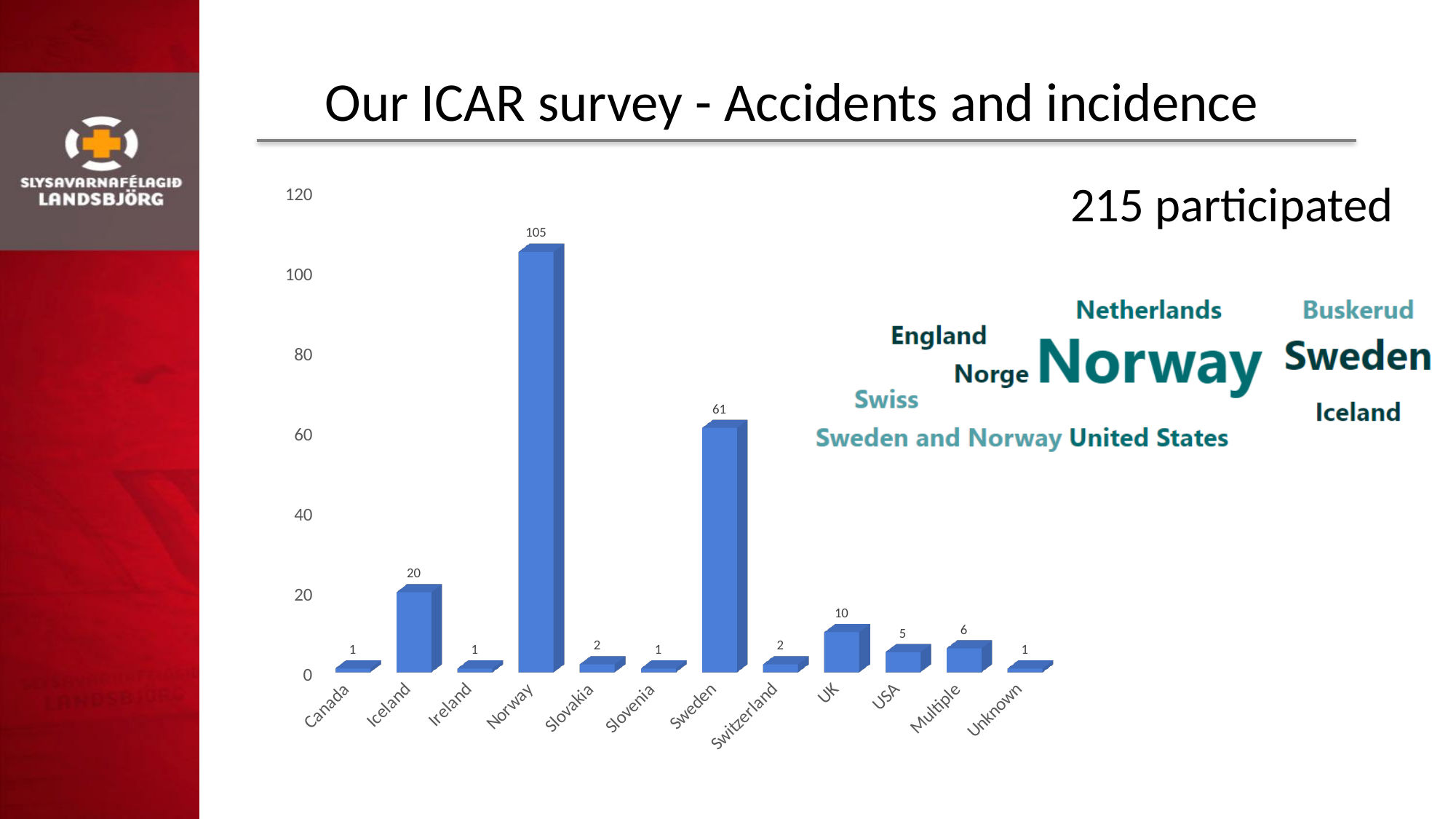
Which is larger, the value for USA or the value for Multiple? Multiple What is the value for Iceland? 20 How many categories are shown on the x axis? 12 What is the value for UK? 10 What is the difference between the values for Iceland and UK? 10 What is the value for Sweden? 61 What is the value for Norway? 105 What is the difference between the values for Norway and Sweden? 44 Is the value for Norway greater or less than 100? greater What kind of chart is shown on the slide? bar chart What is the value for Switzerland? 2 Which category has the highest value? Norway